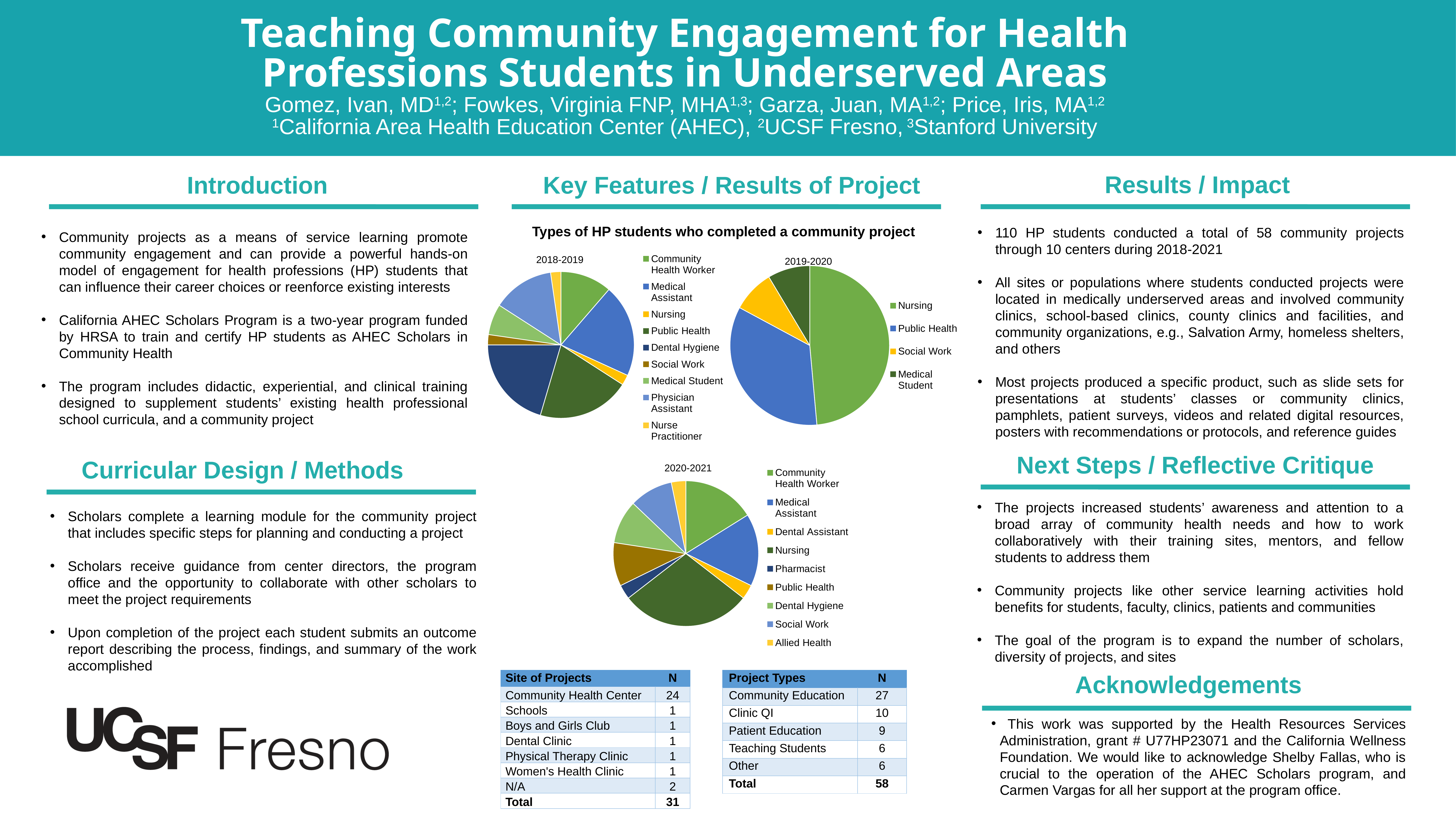
In the 2018-2019 pie chart, which slice is larger: Medical Assistant or Social Work? Medical Assistant How many categories does the legend of the 2018-2019 pie chart list? 9 In the 2020-2021 pie chart, which category has the largest slice? Nursing How many categories does the legend of the 2020-2021 pie chart list? 9 In the 2020-2021 pie chart, which slice is larger: Community Health Worker or Dental Assistant? Community Health Worker What is the overall title above the three pie charts? Types of HP students who completed a community project In the 2019-2020 pie chart, which category has the largest slice? Nursing In the 2019-2020 pie chart, which slice is larger: Nursing or Public Health? Nursing How many categories does the legend of the 2019-2020 pie chart list? 4 Which category is listed first in the legend of the 2019-2020 pie chart? Nursing What kind of chart is used for the 2018-2019 data? Pie chart